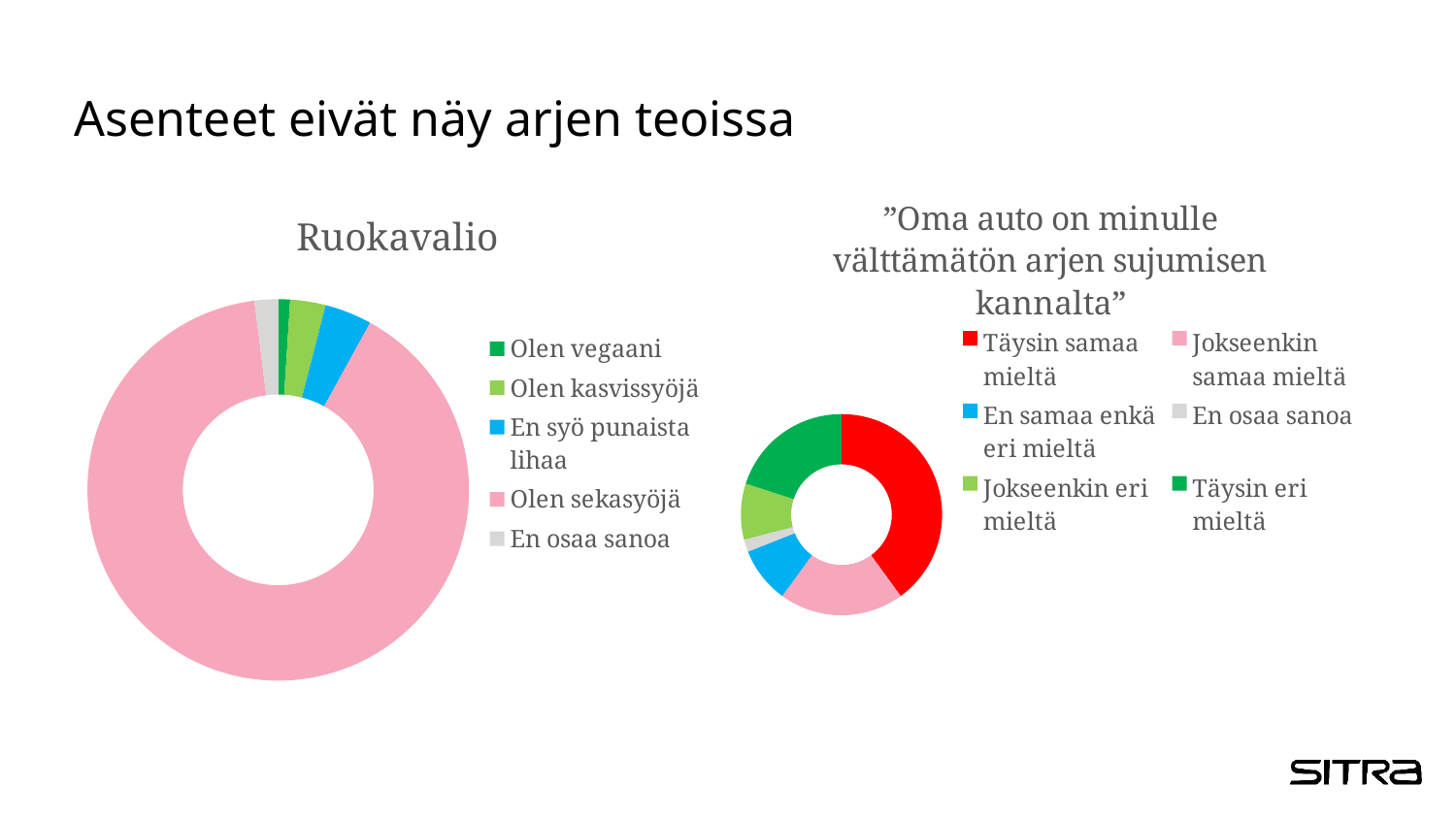
What kind of chart is the "Ruokavalio" chart on the left? Doughnut chart In the chart on the right ("Oma auto on minulle välttämätön arjen sujumisen kannalta"), which slice is larger: "Täysin eri mieltä" or "Jokseenkin eri mieltä"? Täysin eri mieltä What kind of chart is the chart on the right about "Oma auto on minulle välttämätön arjen sujumisen kannalta"? Doughnut chart In the chart on the right ("Oma auto on minulle välttämätön arjen sujumisen kannalta"), how many categories does the legend list? 6 In the "Ruokavalio" chart, which category has the largest slice? Olen sekasyöjä In the "Ruokavalio" chart, what colour represents "Olen sekasyöjä"? Pink In the "Ruokavalio" chart, how many categories does the legend list? 5 What is the title of the chart on the left? Ruokavalio In the chart on the right ("Oma auto on minulle välttämätön arjen sujumisen kannalta"), which category has the smallest slice? En osaa sanoa In the chart on the right ("Oma auto on minulle välttämätön arjen sujumisen kannalta"), which category has the largest slice? Täysin samaa mieltä In the chart on the right ("Oma auto on minulle välttämätön arjen sujumisen kannalta"), which slice is larger: "Täysin samaa mieltä" or "Jokseenkin samaa mieltä"? Täysin samaa mieltä In the "Ruokavalio" chart, which slice is larger: "Olen sekasyöjä" or "Olen vegaani"? Olen sekasyöjä